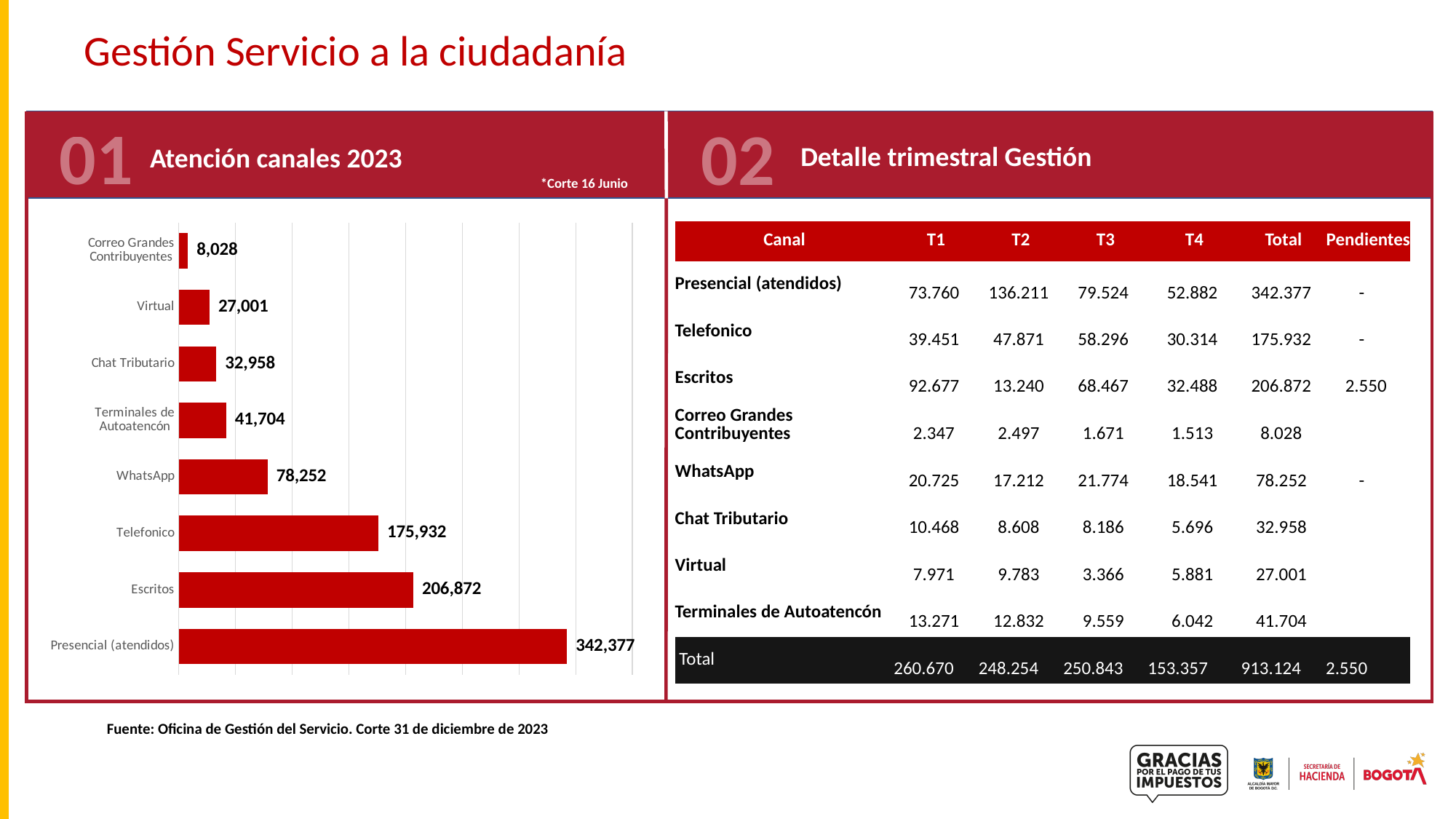
Which is larger in the bar chart, WhatsApp or Terminales de Autoatencón? WhatsApp What is the value for Presencial (atendidos) in the bar chart? 342,377 What is the title of the bar chart panel? Atención canales 2023 Which channel has the highest value in the bar chart? Presencial (atendidos) How many channels are shown in the bar chart? 8 What is the value for Chat Tributario in the bar chart? 32,958 Which channel has the lowest value in the bar chart? Correo Grandes Contribuyentes What is the value for WhatsApp in the bar chart? 78,252 What kind of chart is shown under "Atención canales 2023"? Bar chart What is the difference between Virtual and Correo Grandes Contribuyentes in the bar chart? 18,973 What is the difference between Escritos and Telefonico in the bar chart? 30,940 What is the value for Terminales de Autoatencón in the bar chart? 41,704